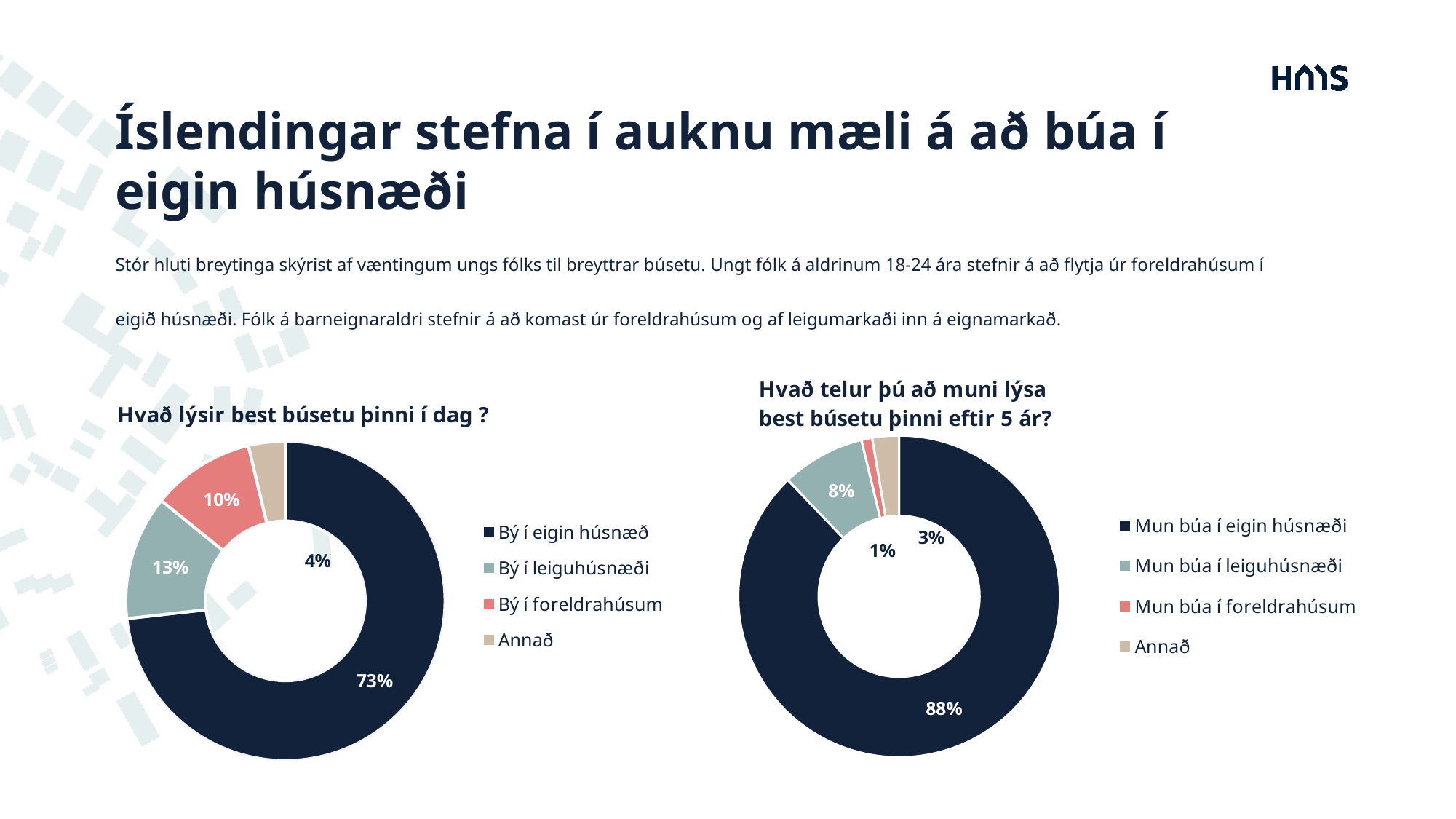
In the chart titled "Hvað lýsir best búsetu þinni í dag ?", which category has the smallest share? Annað What kind of chart is the chart titled "Hvað telur þú að muni lýsa best búsetu þinni eftir 5 ár?"? Doughnut chart In the chart titled "Hvað lýsir best búsetu þinni í dag ?", what percentage is shown for "Bý í eigin húsnæð"? 73% In the chart titled "Hvað lýsir best búsetu þinni í dag ?", what is the difference between the shares for "Bý í leiguhúsnæði" and "Bý í foreldrahúsum"? 3% In the chart titled "Hvað lýsir best búsetu þinni í dag ?", what percentage is shown for "Bý í leiguhúsnæði"? 13% In the chart titled "Hvað telur þú að muni lýsa best búsetu þinni eftir 5 ár?", what percentage is shown for "Mun búa í leiguhúsnæði"? 8% In the chart titled "Hvað lýsir best búsetu þinni í dag ?", what percentage is shown for "Bý í foreldrahúsum"? 10% In the chart titled "Hvað telur þú að muni lýsa best búsetu þinni eftir 5 ár?", what percentage is shown for "Mun búa í eigin húsnæði"? 88% Which is larger: the share for "Bý í eigin húsnæð" in the left chart or the share for "Mun búa í eigin húsnæði" in the right chart? Mun búa í eigin húsnæði In the chart titled "Hvað telur þú að muni lýsa best búsetu þinni eftir 5 ár?", what colour is the slice for "Mun búa í foreldrahúsum"? Red How many categories does the legend of the chart titled "Hvað lýsir best búsetu þinni í dag ?" list? 4 In the chart titled "Hvað telur þú að muni lýsa best búsetu þinni eftir 5 ár?", which category has the largest share? Mun búa í eigin húsnæði